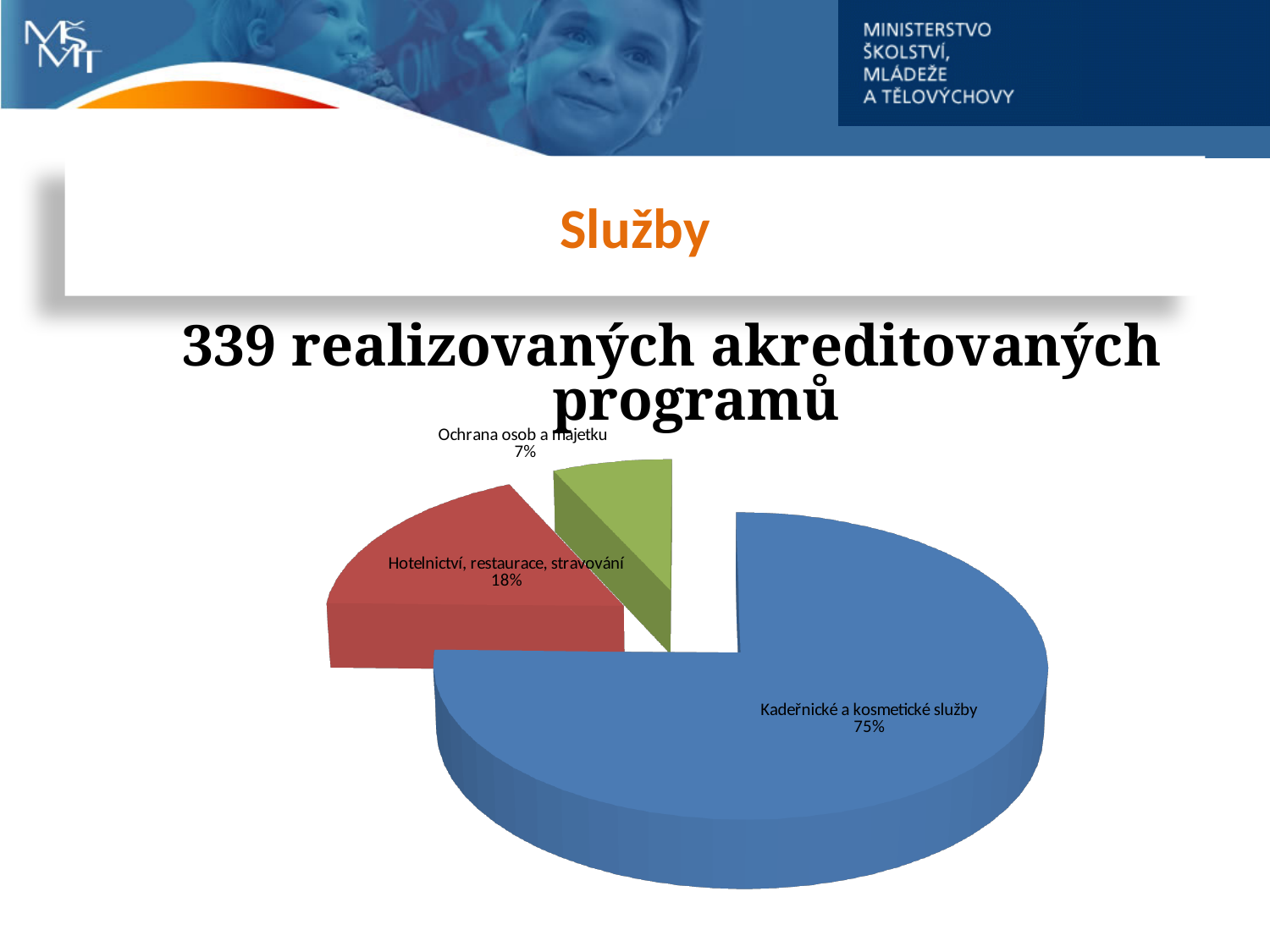
What colour is the slice for Kadeřnické a kosmetické služby? blue What share of the pie does Ochrana osob a majetku have? 7% Which is larger: the share for Hotelnictví, restaurace, stravování or the share for Ochrana osob a majetku? Hotelnictví, restaurace, stravování What is the difference in percentage points between Kadeřnické a kosmetické služby and Hotelnictví, restaurace, stravování? 57 percentage points What is the title of the slide containing the pie chart? Služby Which category has the largest slice of the pie? Kadeřnické a kosmetické služby What kind of chart is shown on the slide? pie chart What is the difference in percentage points between Hotelnictví, restaurace, stravování and Ochrana osob a majetku? 11 percentage points How many slices does the pie chart have? 3 What share of the pie does Kadeřnické a kosmetické služby have? 75% What share of the pie does Hotelnictví, restaurace, stravování have? 18% Which category has the smallest slice of the pie? Ochrana osob a majetku